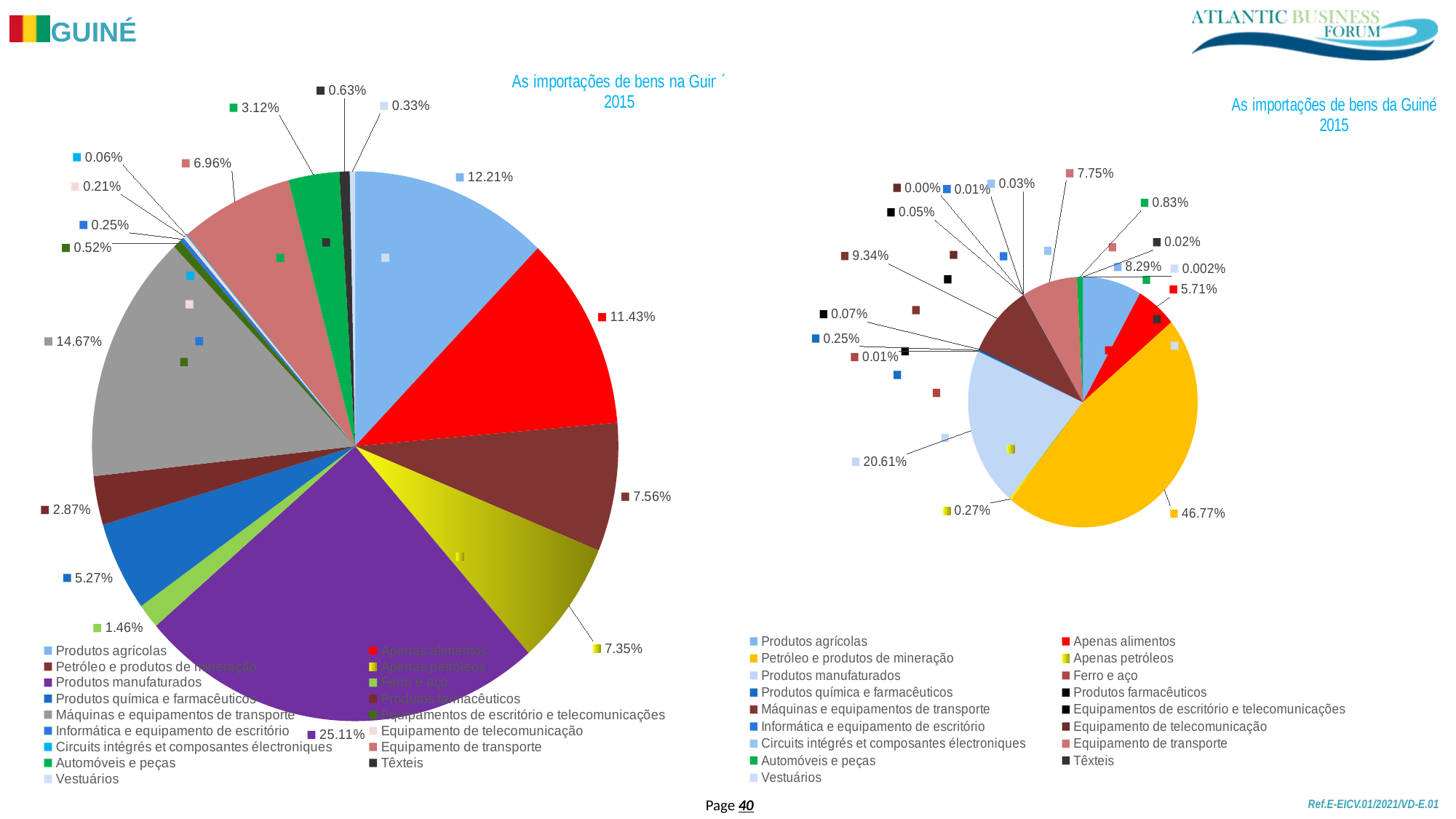
On the left pie chart, which category has the largest slice? Produtos manufaturados On the right pie chart, what is the difference between the shares of Produtos agrícolas and Apenas alimentos? 2.58% On the right pie chart, what share is shown for Petróleo e produtos de mineração? 46.77% On the right pie chart, which is larger: Máquinas e equipamentos de transporte or Apenas petróleos? Máquinas e equipamentos de transporte On the left pie chart, which is larger: Equipamento de transporte or Automóveis e peças? Equipamento de transporte On the left pie chart, what is the difference between the shares of Produtos agrícolas and Apenas alimentos? 0.78% What type of chart is used on the right side of the slide? Pie chart On the left pie chart, what share is shown for Máquinas e equipamentos de transporte? 14.67% On the left pie chart, what share is shown for Produtos manufaturados? 25.11% How many categories does the legend of the right pie chart list? 17 On the right pie chart, which category has the largest slice? Petróleo e produtos de mineração On the right pie chart, what share is shown for Produtos manufaturados? 20.61%